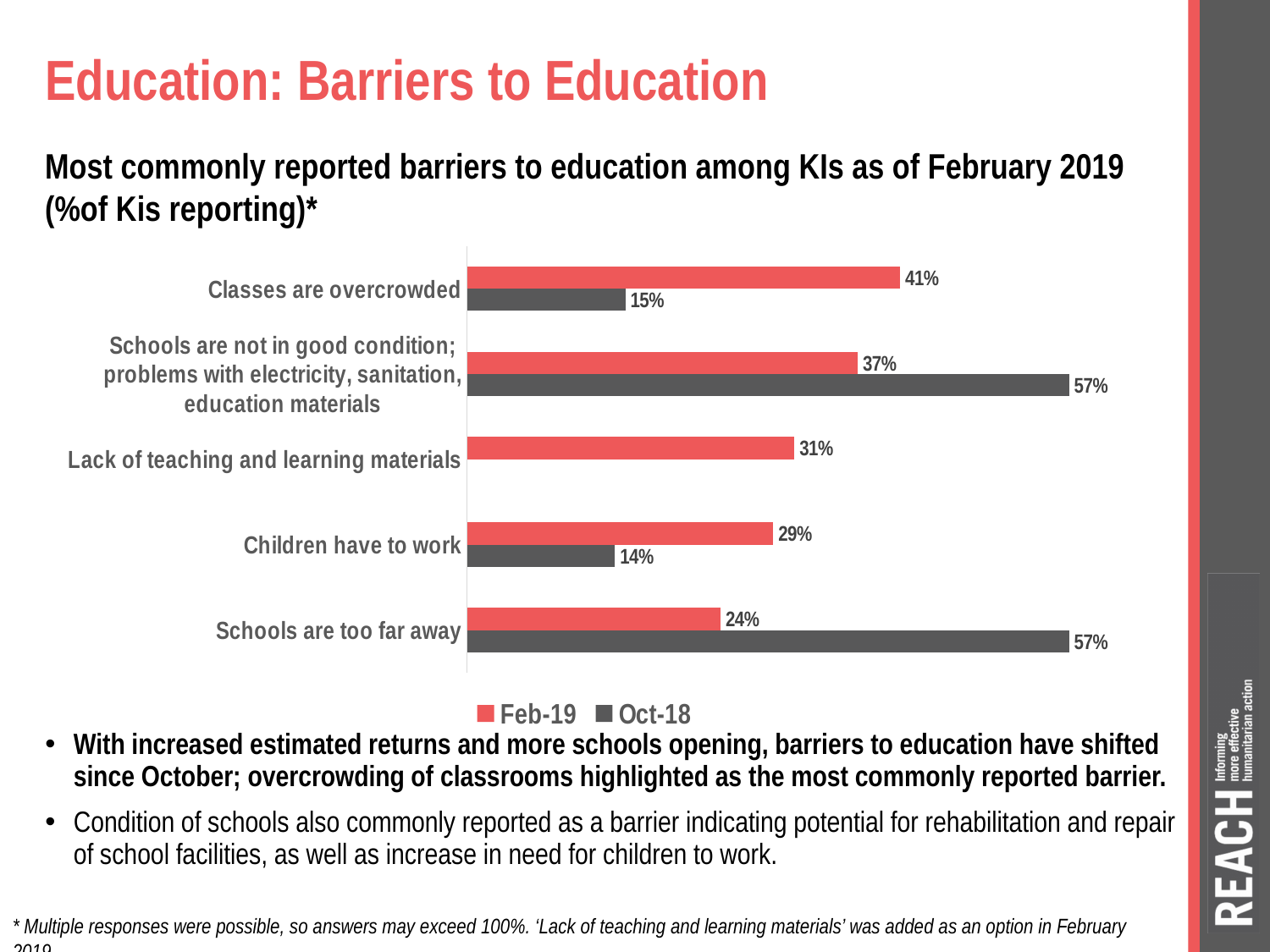
What colour represents the Feb-19 series in the chart? Red What type of chart is shown on the slide? Bar chart What is the difference between the Oct-18 and Feb-19 values for 'Schools are too far away'? 33 percentage points How many series does the legend list? 2 Which barrier has the lowest Feb-19 value? Schools are too far away Which is larger for 'Classes are overcrowded': the Feb-19 value or the Oct-18 value? Feb-19 What is the Oct-18 value for 'Children have to work'? 14% What percentage of KIs reported 'Classes are overcrowded' as a barrier in Feb-19? 41% What percentage of KIs reported 'Schools are too far away' in Oct-18? 57% Which barrier has the highest Feb-19 value? Classes are overcrowded Which barrier has no Oct-18 bar? Lack of teaching and learning materials How many barrier categories are shown in the chart? 5